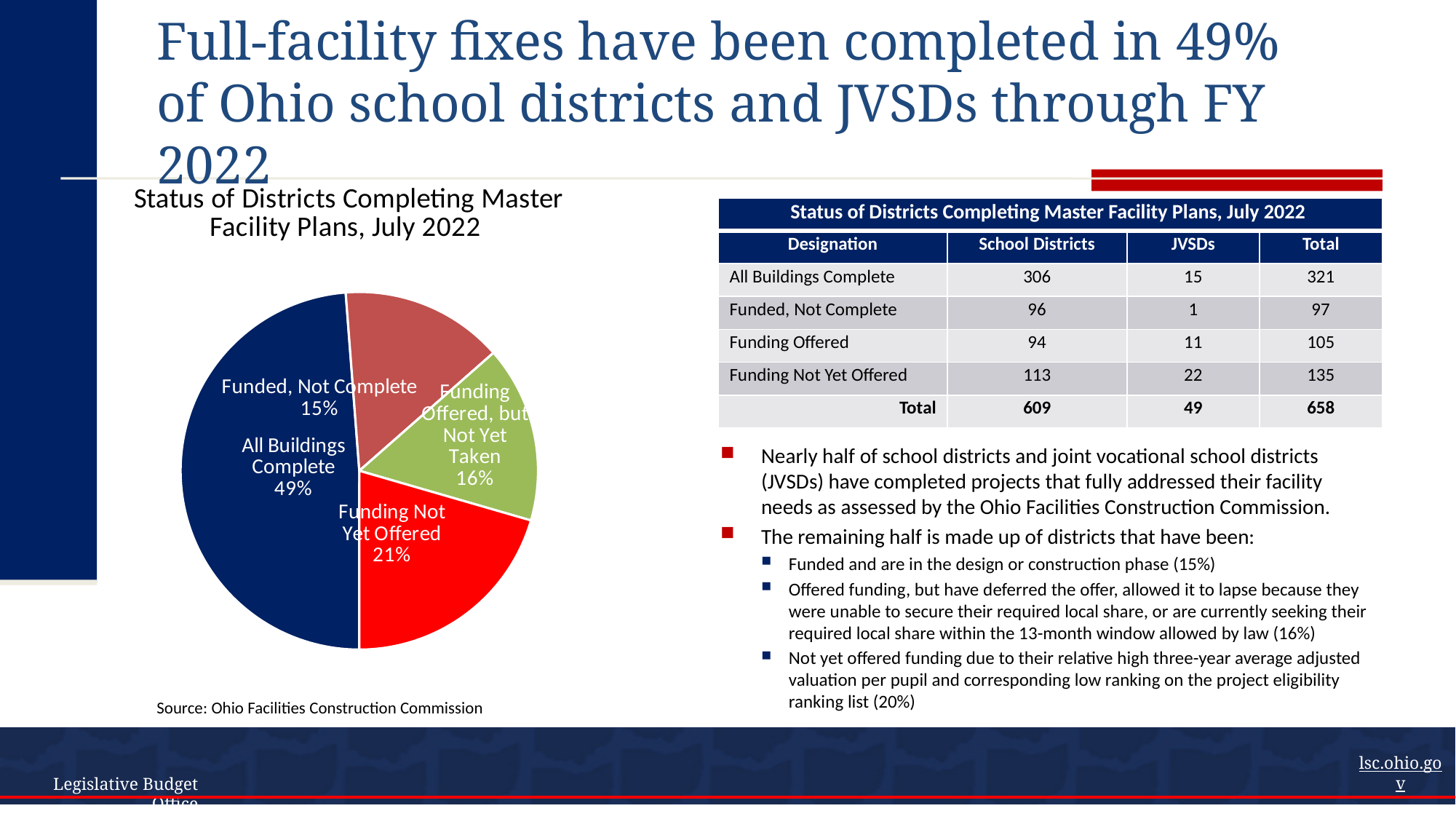
What is the difference in percentage points between the "All Buildings Complete" slice and the "Funding Not Yet Offered" slice? 28 percentage points What colour is the "All Buildings Complete" slice of the pie chart? Dark blue What share of the pie is labelled "Funding Not Yet Offered"? 21% Which slice of the pie chart is the largest? All Buildings Complete Which is larger in the pie chart: "Funding Not Yet Offered" or "Funded, Not Complete"? Funding Not Yet Offered Which slice of the pie chart is the smallest? Funded, Not Complete What share of the pie is labelled "Funding Offered, but Not Yet Taken"? 16% What is the title of the pie chart? Status of Districts Completing Master Facility Plans, July 2022 How many slices does the pie chart have? 4 What kind of chart is shown on the slide? Pie chart What share of the pie is labelled "Funded, Not Complete"? 15%